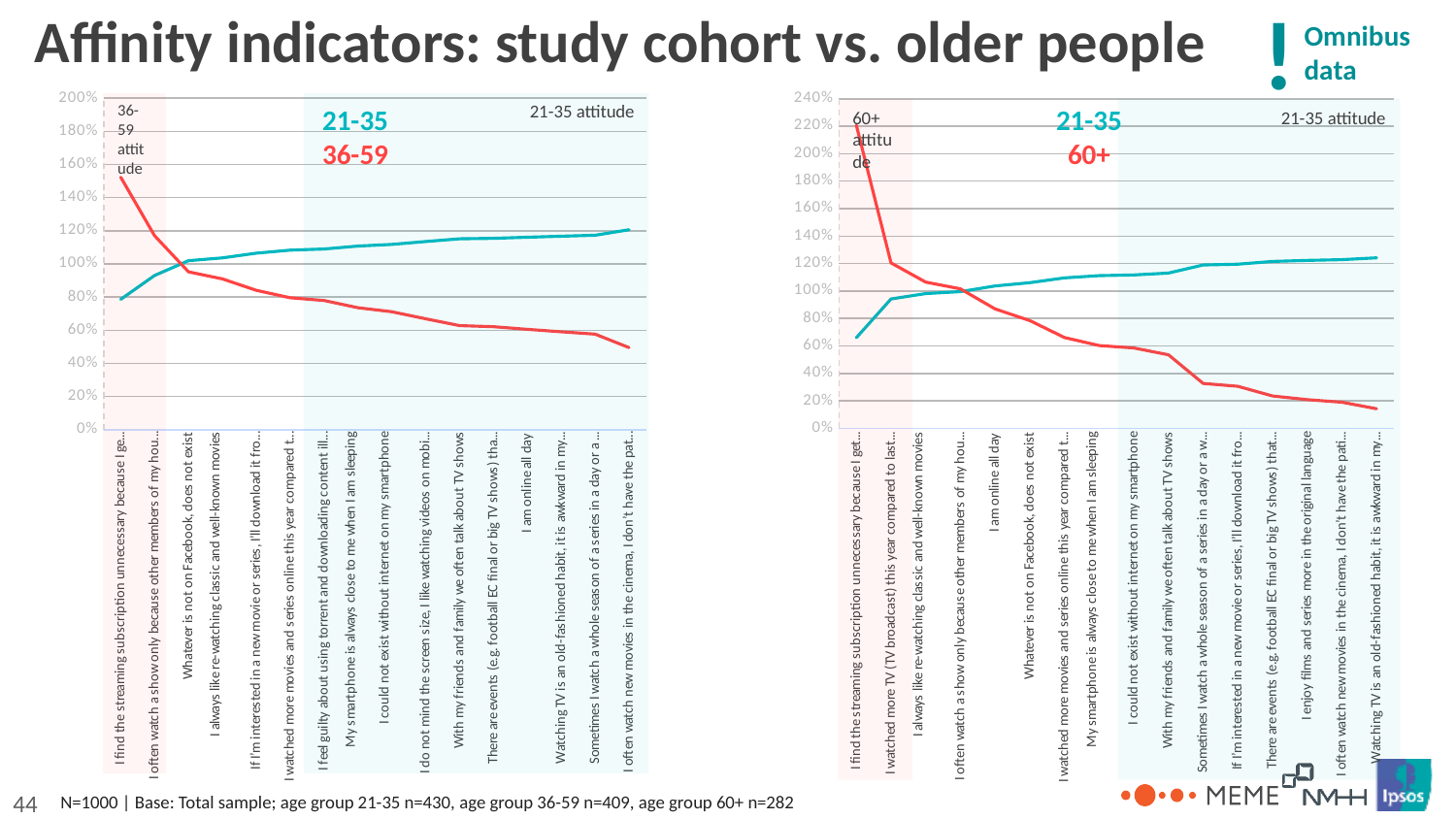
In the left chart, is the 21-35 value for 'I am online all day' greater or less than 100%? greater In the right chart, which series has the higher value for 'With my friends and family we often talk about TV shows', 21-35 or 60+? 21-35 What kind of chart is the left chart on the slide? line chart How many categories are plotted along the x axis of the right chart? 16 In the right chart, is the 21-35 value for 'I could not exist without internet on my smartphone' greater or less than 100%? greater In the right chart, does the 21-35 line rise or fall from left to right along the x axis? rise What is the title of the slide? Affinity indicators: study cohort vs. older people How many series does the legend of the right chart list? 2 In the left chart, is the 36-59 value for 'Whatever is not on Facebook, does not exist' greater or less than 100%? less How many categories are plotted along the x axis of the left chart? 16 In the left chart, does the 36-59 line rise or fall from left to right along the x axis? fall